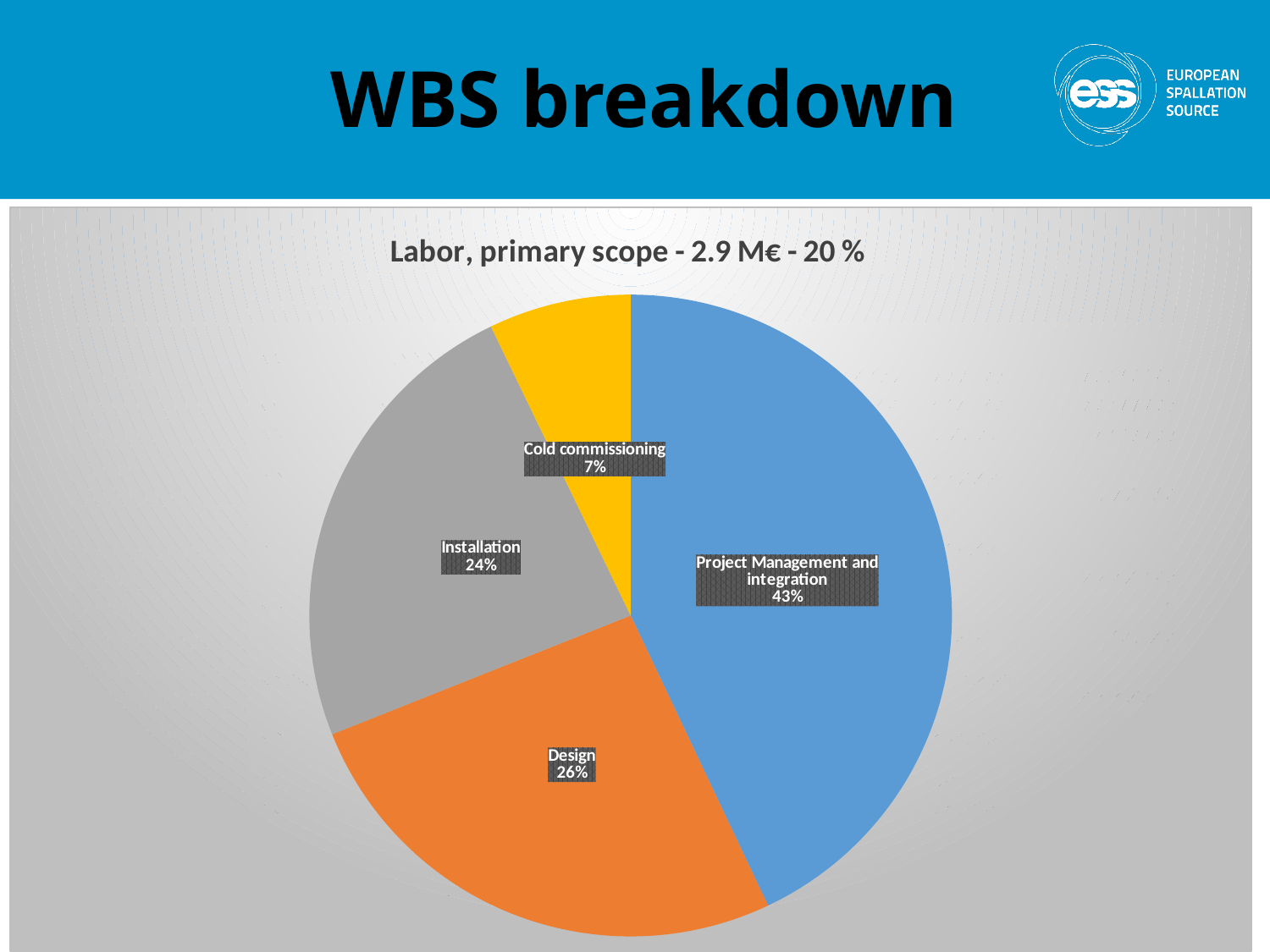
What share of the pie does Installation have? 24% Which slice is the largest? Project Management and integration What is the difference in percentage points between Project Management and integration and Design? 17 How many slices does the pie chart have? 4 What colour is the Installation slice? grey What share of the pie does Project Management and integration have? 43% What share of the pie does Design have? 26% What is the chart's title? Labor, primary scope - 2.9 M€ - 20 % Which is larger, Design or Installation? Design What kind of chart is shown on the slide? pie chart Which slice is the smallest? Cold commissioning